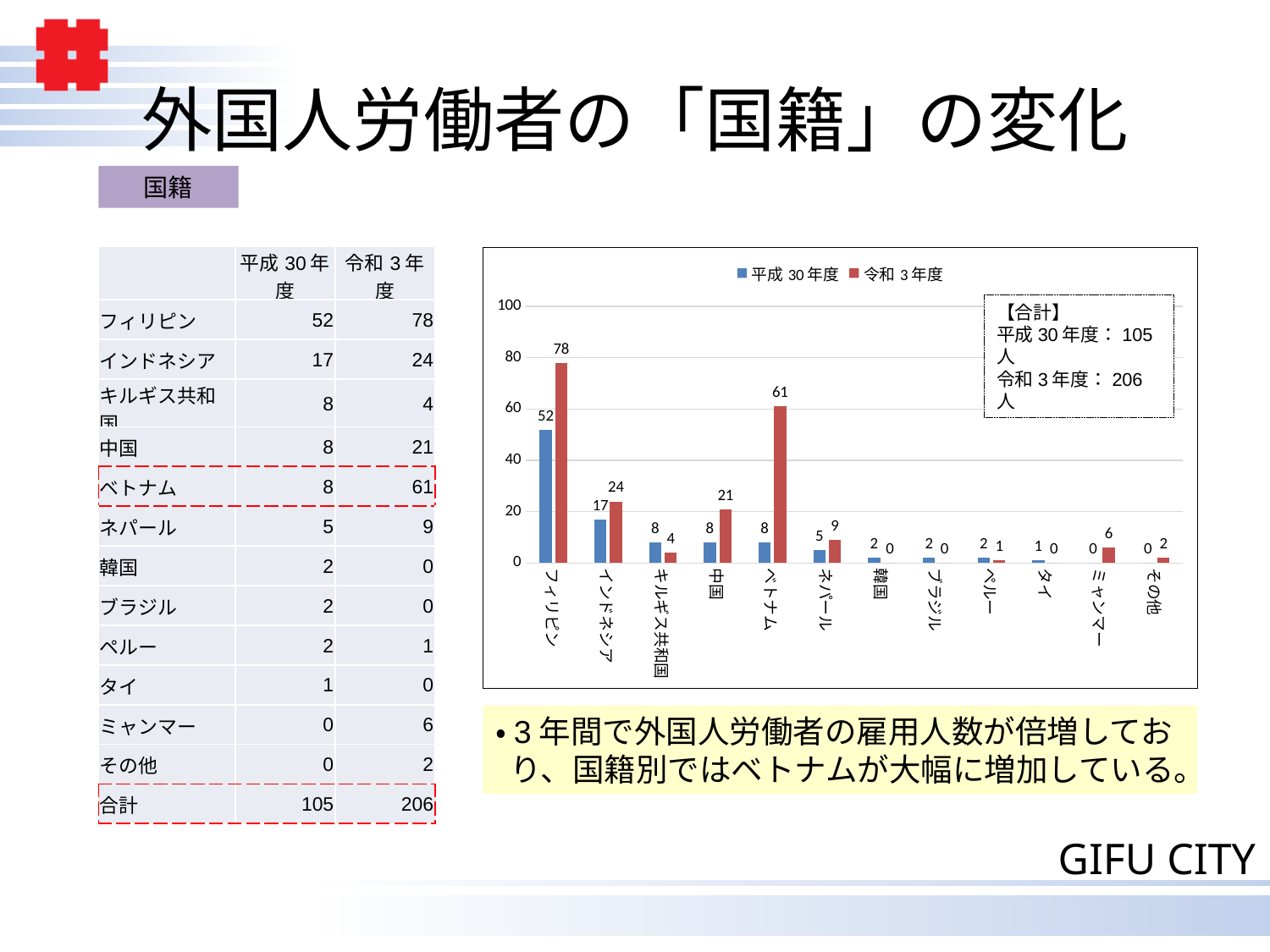
Which is larger for キルギス共和国: the 平成30年度 value or the 令和3年度 value? 平成30年度 How many categories (nationalities) are plotted on the chart's x axis? 12 Which category has the highest value in the 平成30年度 series? フィリピン What is the value for ベトナム in the 令和3年度 series? 61 What is the value for 中国 in the 令和3年度 series? 21 What kind of chart is shown on the slide? bar chart Which category has the highest value in the 令和3年度 series? フィリピン How many series does the chart legend list? 2 What are the two series names shown in the chart legend? 平成30年度 and 令和3年度 What is the difference between the 令和3年度 and 平成30年度 values for ベトナム? 53 What is the value for フィリピン in the 平成30年度 series? 52 Is the 令和3年度 value for フィリピン greater or less than 60? greater